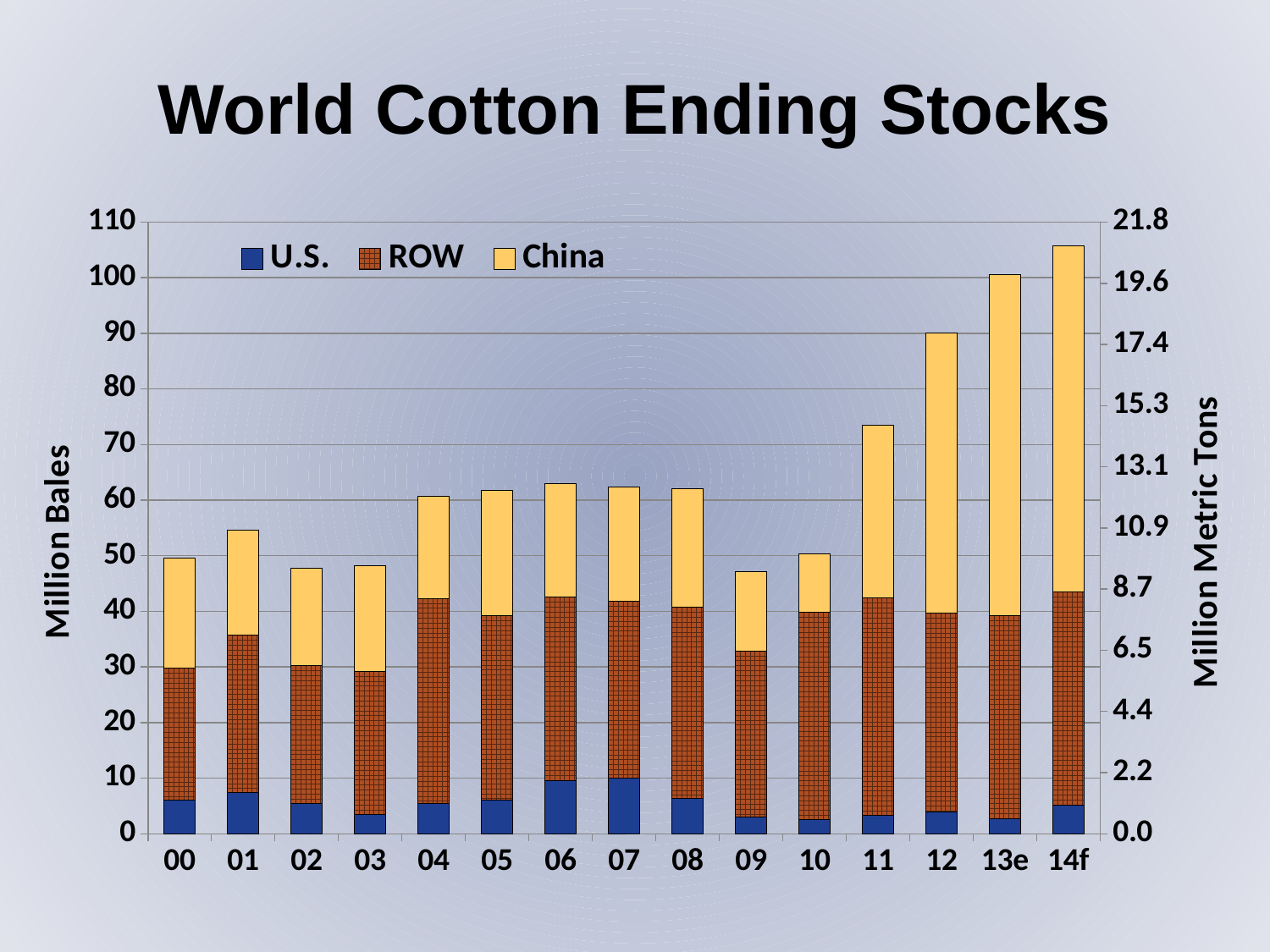
Is the total stacked bar for 01 greater or less than 50 million bales? greater What is the label on the left vertical axis? Million Bales Is the total stacked bar for 14f greater or less than 100 million bales? greater What is the title of the chart? World Cotton Ending Stocks Which has the larger total ending stocks, 13e or 12? 13e Is the total stacked bar for 12 greater or less than 80 million bales? greater What kind of chart is shown on the slide? Stacked bar chart Do total ending stocks rise or fall from 11 through 14f? rise How many years (categories) are shown along the x axis? 15 How many series does the legend list? 3 Which year has the highest total ending stocks? 14f